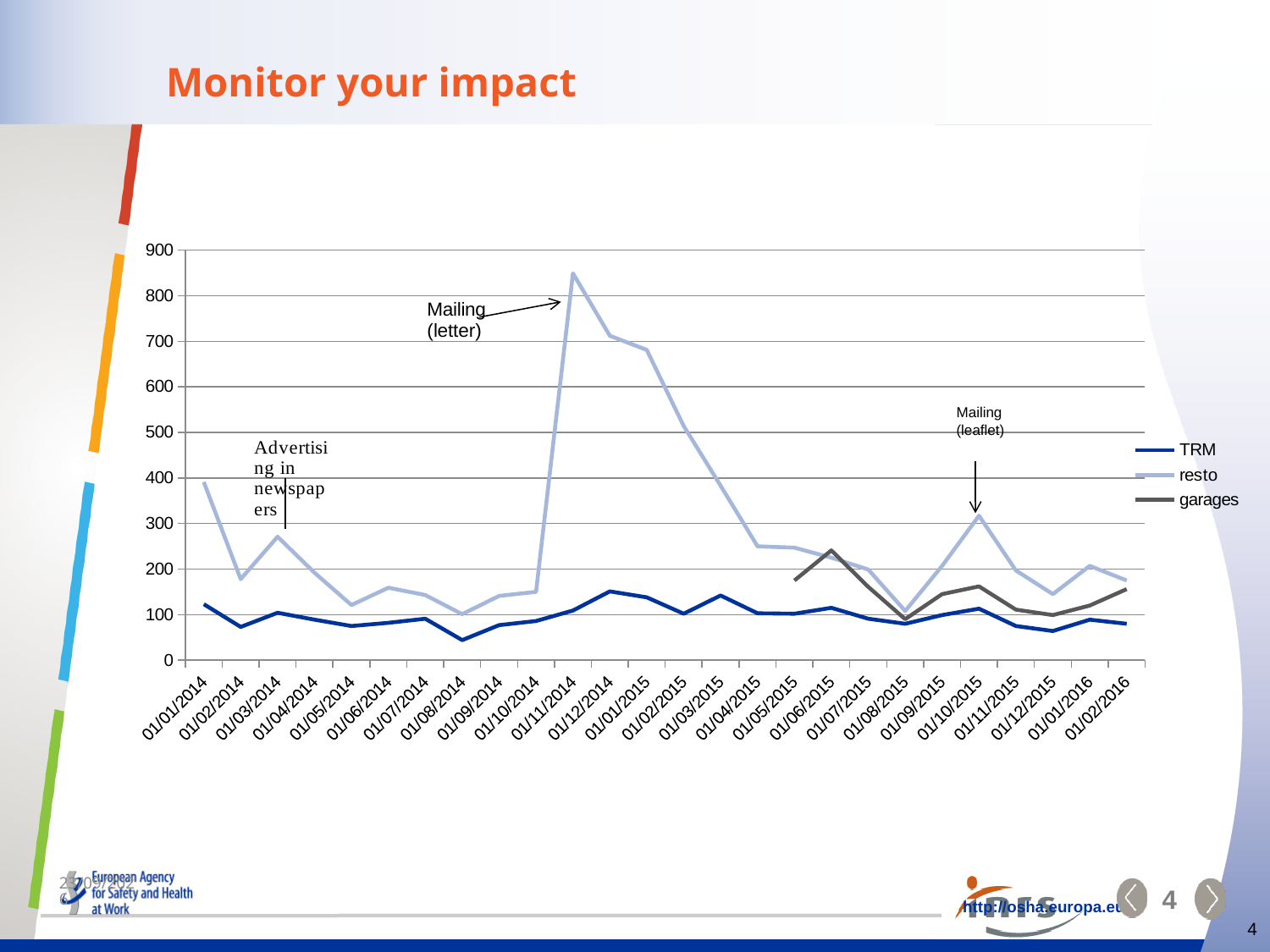
Is the value for garages on 01/06/2015 greater or less than 200? greater How many dates are shown along the x axis? 26 Is the value for TRM on 01/08/2014 greater or less than 100? less Is the value for resto on 01/11/2014 greater or less than 800? greater Which event does the annotation pointing to the peak of the resto series label? Mailing (letter) On which date does the resto series reach its highest value? 01/11/2014 How many series does the legend list? 3 On 01/11/2014, which series has the larger value, resto or TRM? resto What kind of chart is shown on the slide? line chart On which date does the TRM series reach its lowest value? 01/08/2014 Does the resto series rise or fall between 01/11/2014 and 01/04/2015? fall